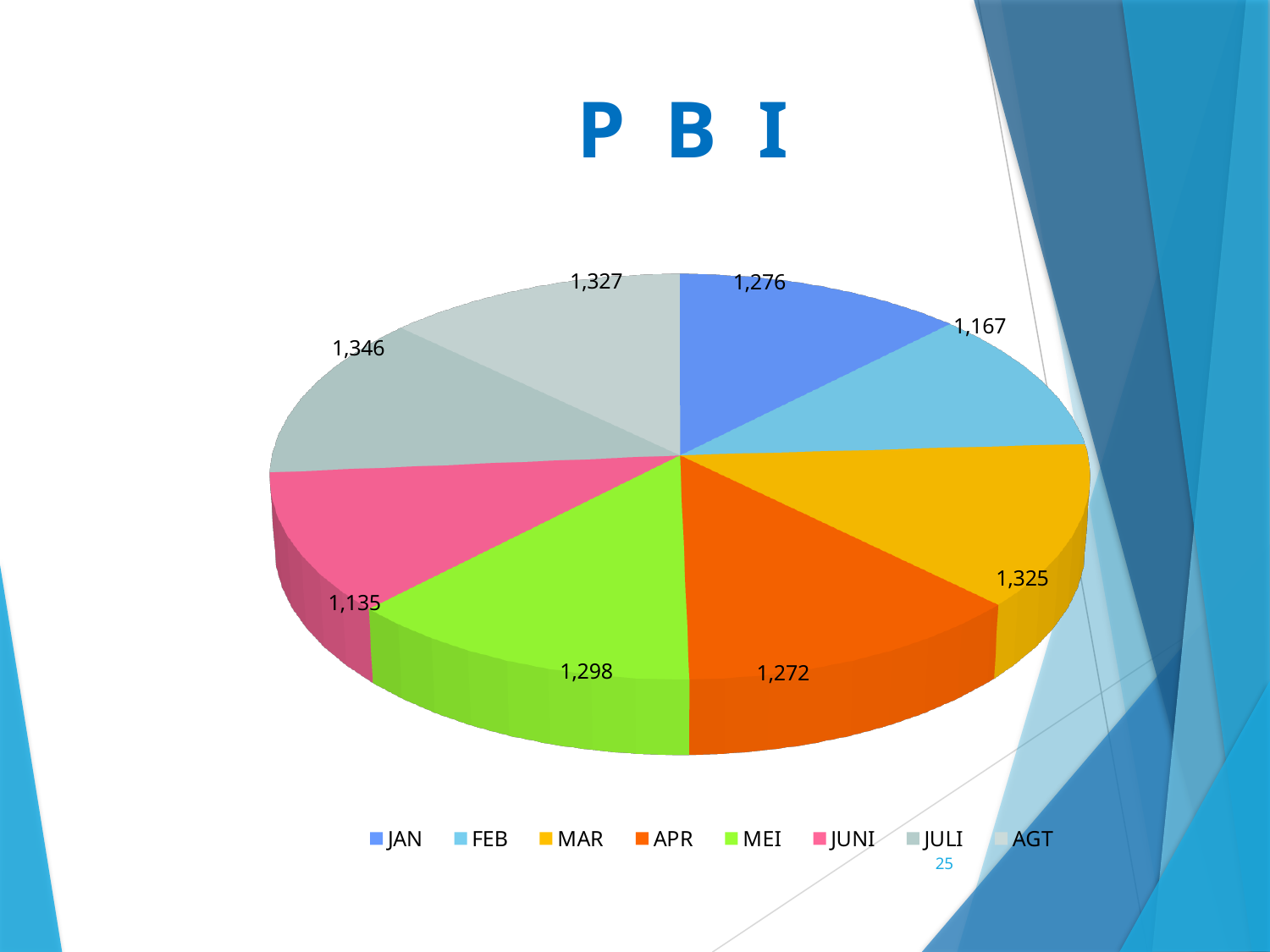
How many slices does the pie chart have? 8 Which is larger, the value for MAR or the value for FEB? MAR What colour is the slice for APR? orange Which month has the lowest value? JUNI What is the title of the chart? P B I What is the value for FEB? 1,167 What is the value for JAN? 1,276 What is the difference between the values for JULI and JUNI? 211 Which month has the highest value? JULI What is the value for AGT? 1,327 What type of chart is shown on the slide? pie chart What is the value for MEI? 1,298